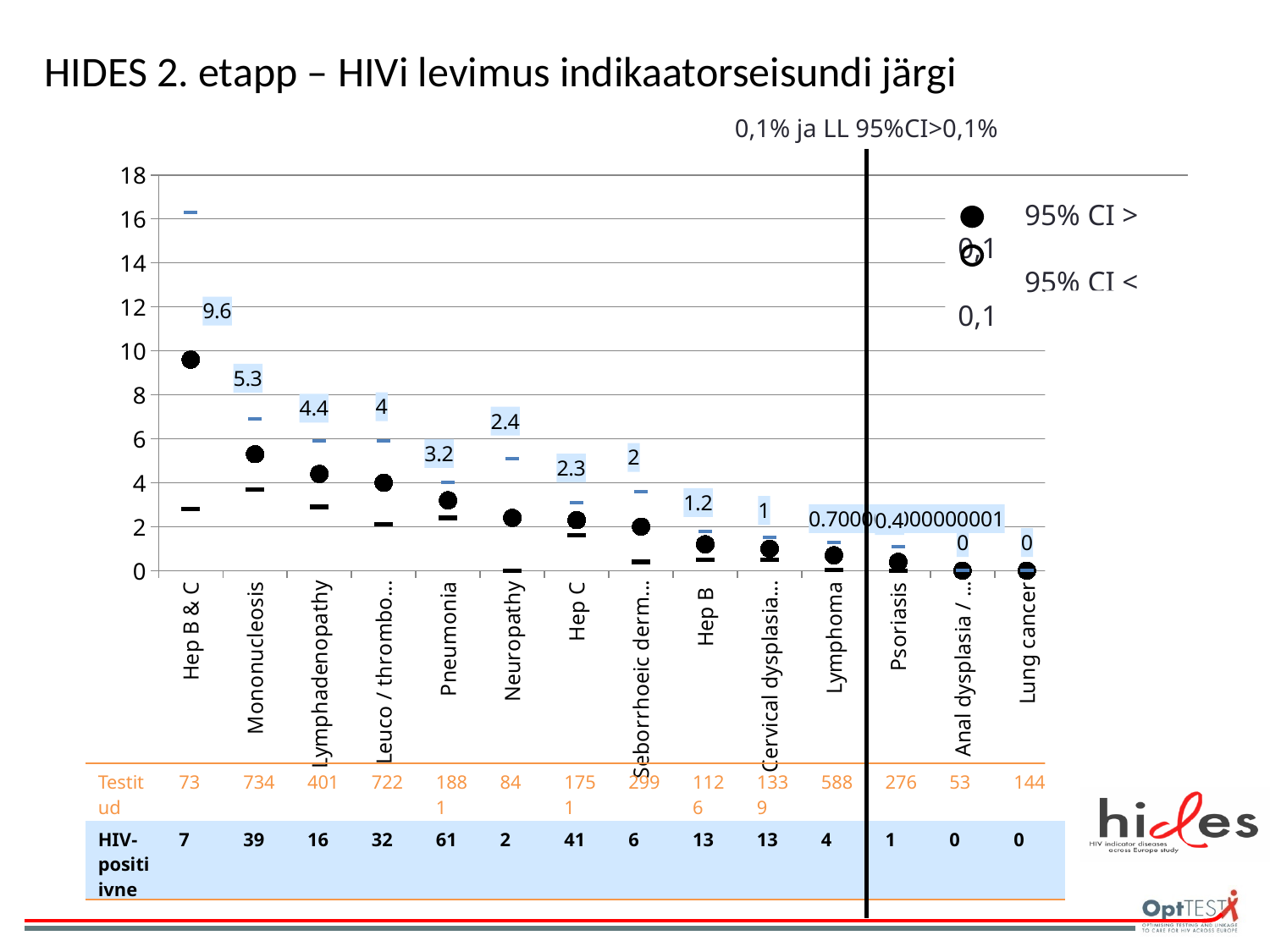
What is the value plotted for Mononucleosis? 5.3 What is the difference between the values for Hep B & C and Mononucleosis? 4.3 Do the plotted values rise or fall from left to right along the x axis? fall What kind of chart is shown on the slide? scatter chart Which category has the highest plotted value? Hep B & C How many categories are shown on the x axis of the chart? 14 Which has a larger plotted value, Lymphadenopathy or Hep C? Lymphadenopathy What is the value plotted for Hep B? 1.2 What is the value plotted for Hep B & C? 9.6 How many series does the legend list? 2 Is the value for Neuropathy greater or less than 4? less What is the value plotted for Pneumonia? 3.2